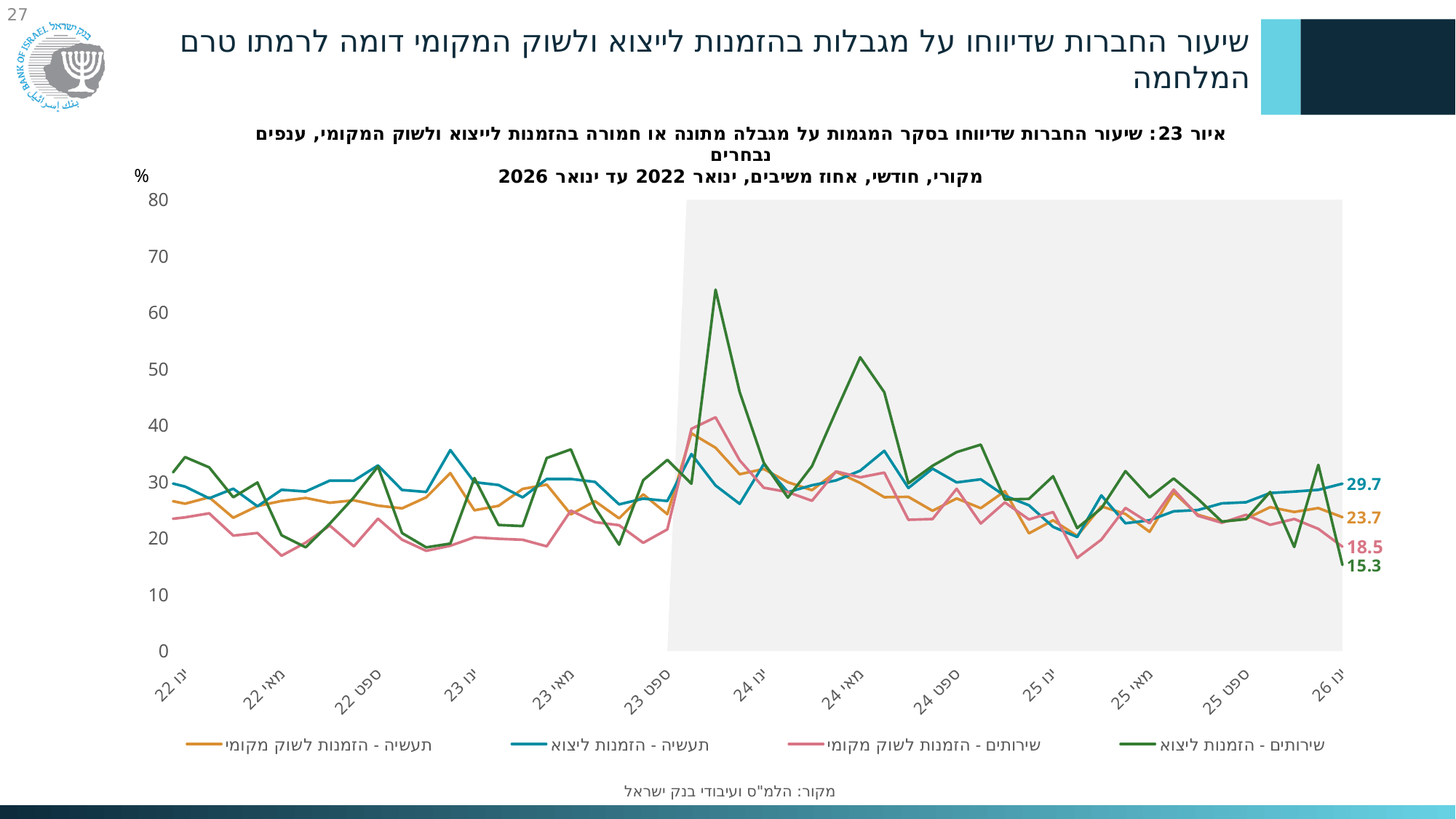
Is the peak value of the green series 'שירותים - הזמנות ליצוא' in late 2023 greater or less than 60? greater At the end of the chart, which is larger: the value for 'תעשיה - הזמנות לשוק מקומי' or the value for 'שירותים - הזמנות לשוק מקומי'? תעשיה - הזמנות לשוק מקומי What colour is the line for the series 'שירותים - הזמנות ליצוא'? green What is the final value (January 2026) shown for the series 'תעשיה - הזמנות לשוק מקומי'? 23.7 Which series has the lowest value at the end of the chart (January 2026)? שירותים - הזמנות ליצוא What is the difference between the final values of 'תעשיה - הזמנות ליצוא' (29.7) and 'שירותים - הזמנות ליצוא' (15.3)? 14.4 Which series has the highest value at the end of the chart (January 2026)? תעשיה - הזמנות ליצוא What is the final value (January 2026) shown for the series 'תעשיה - הזמנות ליצוא'? 29.7 What is the final value (January 2026) shown for the series 'שירותים - הזמנות לשוק מקומי'? 18.5 What is the final value (January 2026) shown for the series 'שירותים - הזמנות ליצוא'? 15.3 How many series does the legend list? 4 What kind of chart is shown on the slide? line chart